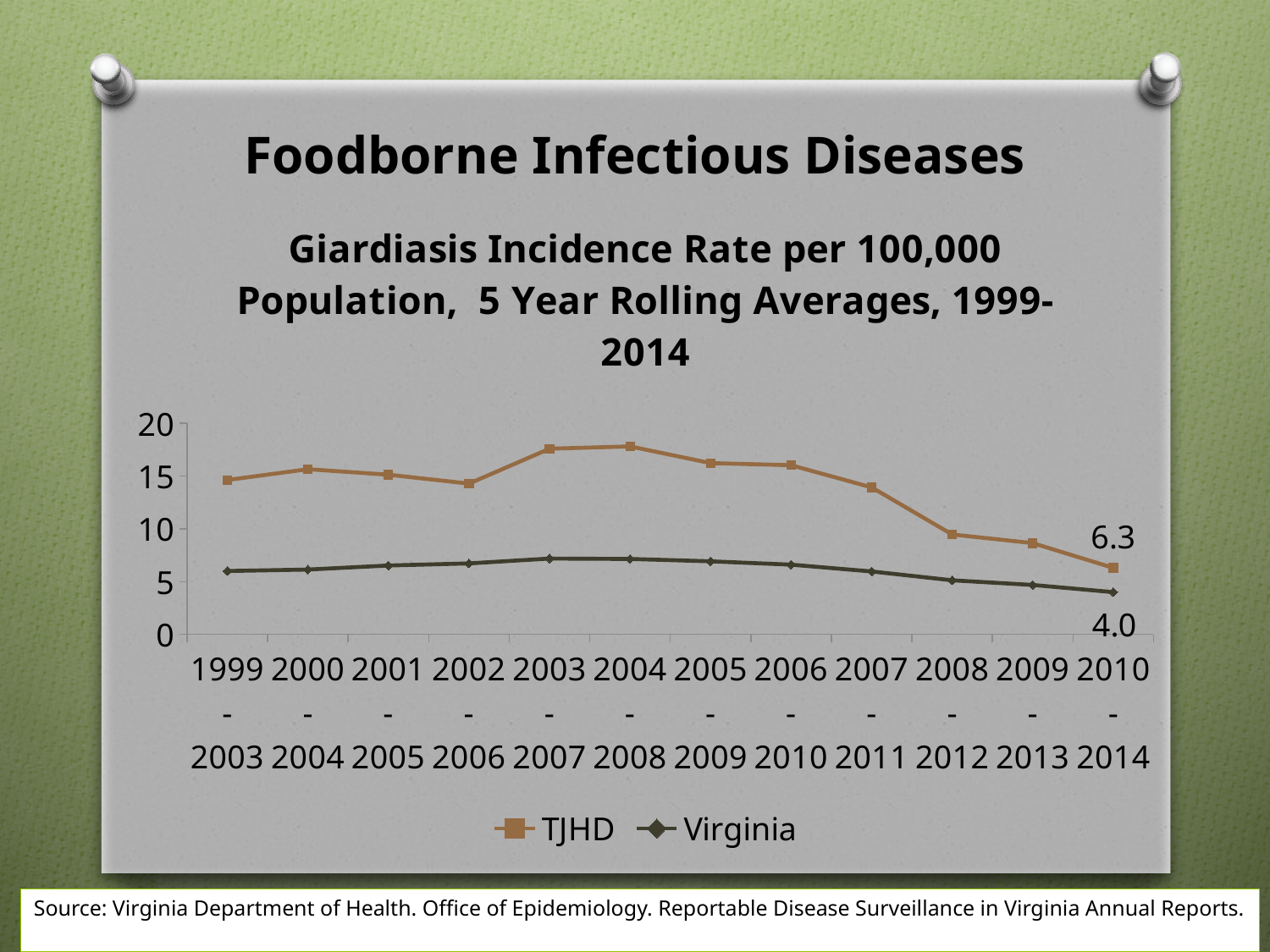
In which period is the TJHD series at its lowest? 2010-2014 What kind of chart is shown on the slide? line chart Which series has the larger value for 2010-2014, TJHD or Virginia? TJHD What is the Virginia value for the 2010-2014 period? 4.0 What is the TJHD value for the 2010-2014 period? 6.3 How many series does the legend list? 2 How many time periods are shown on the x axis? 12 Is the Virginia value for 2003-2007 greater or less than 10? less Does the TJHD series rise or fall from 2004-2008 to 2010-2014? fall What is the difference between the TJHD and Virginia values for 2010-2014? 2.3 Is the TJHD value for 2004-2008 greater or less than 15? greater Is the TJHD value for 1999-2003 greater or less than 10? greater